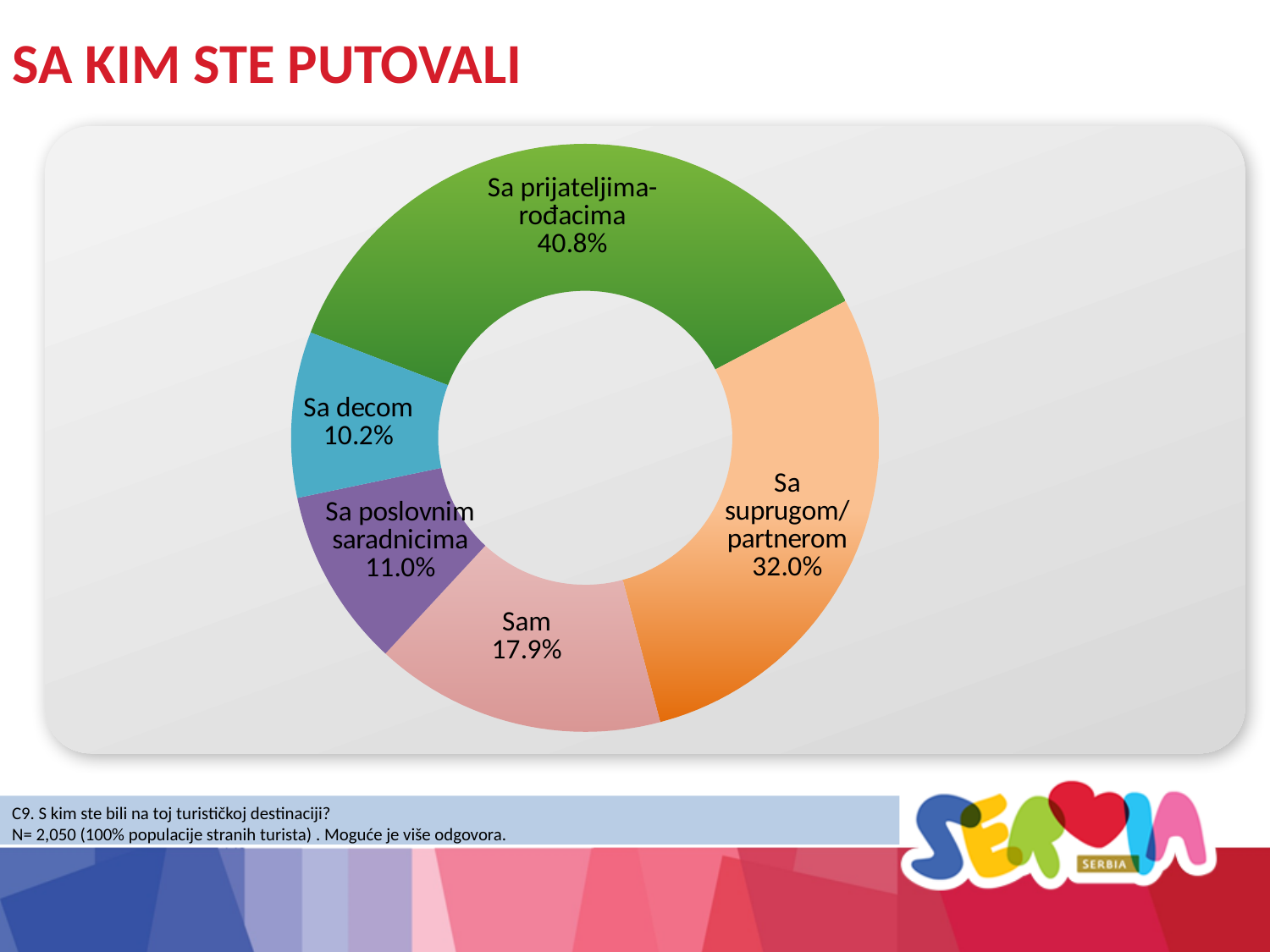
What percentage of respondents travelled with children (Sa decom)? 10.2% What percentage of respondents travelled with friends/relatives (Sa prijateljima-rođacima)? 40.8% What kind of chart is shown on the slide? doughnut chart Which category has the largest share in the chart? Sa prijateljima-rođacima Which is larger: 'Sa poslovnim saradnicima' or 'Sa decom'? Sa poslovnim saradnicima What is the value for 'Sa poslovnim saradnicima'? 11.0% Which category has the smallest share in the chart? Sa decom What is the difference between the 'Sa prijateljima-rođacima' and 'Sa suprugom/partnerom' values? 8.8% What is the difference between the 'Sam' and 'Sa decom' values? 7.7% What is the value shown for 'Sa suprugom/partnerom'? 32.0% How many categories are shown in the chart? 5 What percentage is shown for the 'Sam' slice? 17.9%